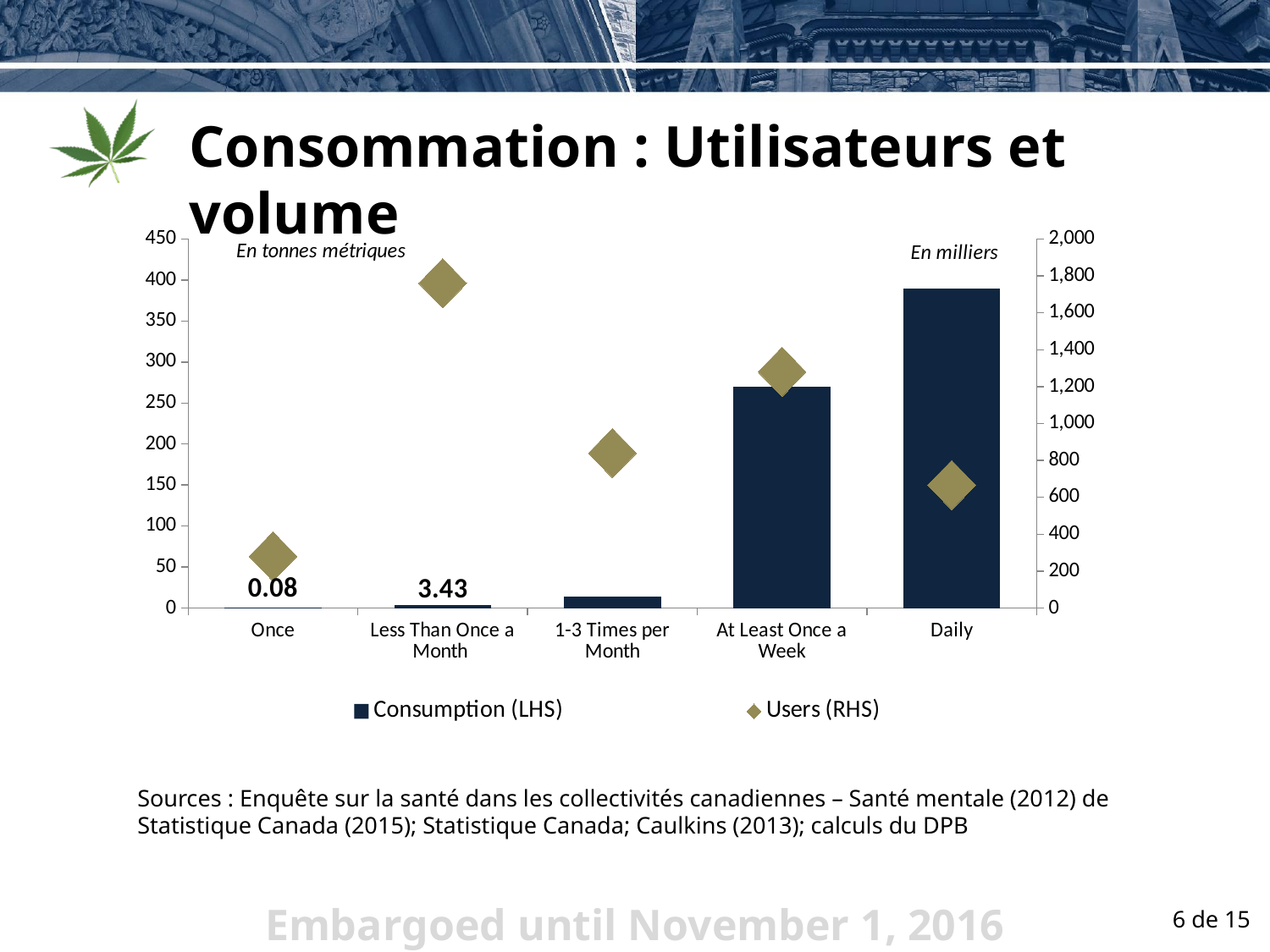
Which has the larger Users (RHS) value: 1-3 Times per Month or Daily? 1-3 Times per Month Which category has the lowest Users (RHS) value? Once Which category has the highest Users (RHS) value? Less Than Once a Month What is the Consumption (LHS) value for the Once category? 0.08 Which category has the highest Consumption (LHS) bar? Daily How many categories are shown on the x axis? 5 Is the Consumption (LHS) value for Daily greater or less than 350? greater Is the Users (RHS) value for Daily greater or less than 800? less Which category has the lowest Consumption (LHS) bar? Once What is the difference between the Consumption (LHS) values for Less Than Once a Month and Once? 3.35 How many series does the legend list? 2 What is the Consumption (LHS) value for the Less Than Once a Month category? 3.43